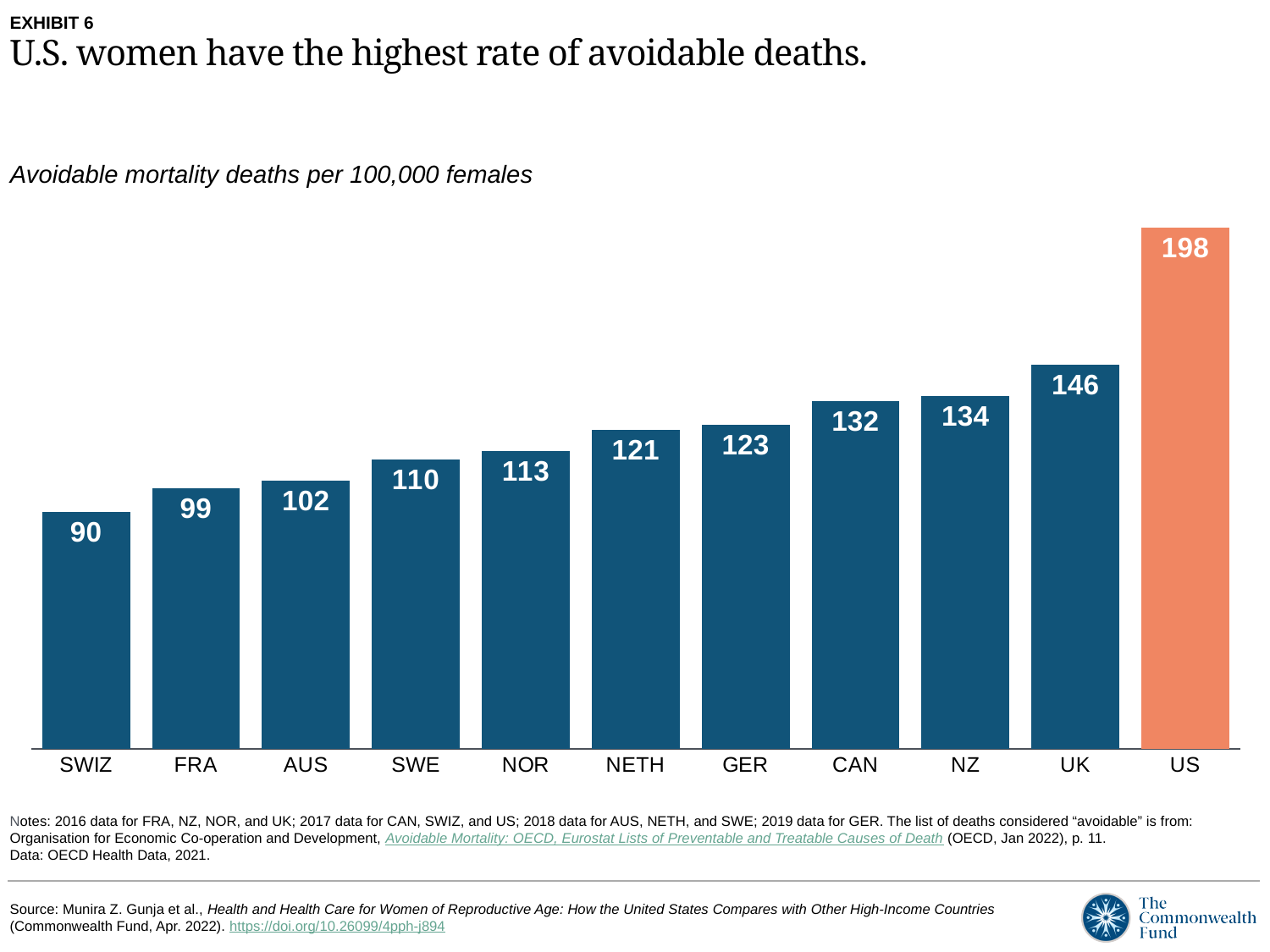
What is the avoidable mortality rate per 100,000 females for the US? 198 Which country has the lowest rate of avoidable deaths? SWIZ What is the difference between the values for the US and the UK? 52 Which country has the highest rate of avoidable deaths? US What type of chart is shown on the slide? Bar chart What is the difference between the values for CAN and FRA? 33 Do the values rise or fall moving from left to right across the chart? Rise Which bar is shown in a different colour (orange) from the others? US What is the value shown for SWE? 110 Which has a higher value, GER or NOR? GER What is the value shown for NETH? 121 How many countries are shown in the chart? 11